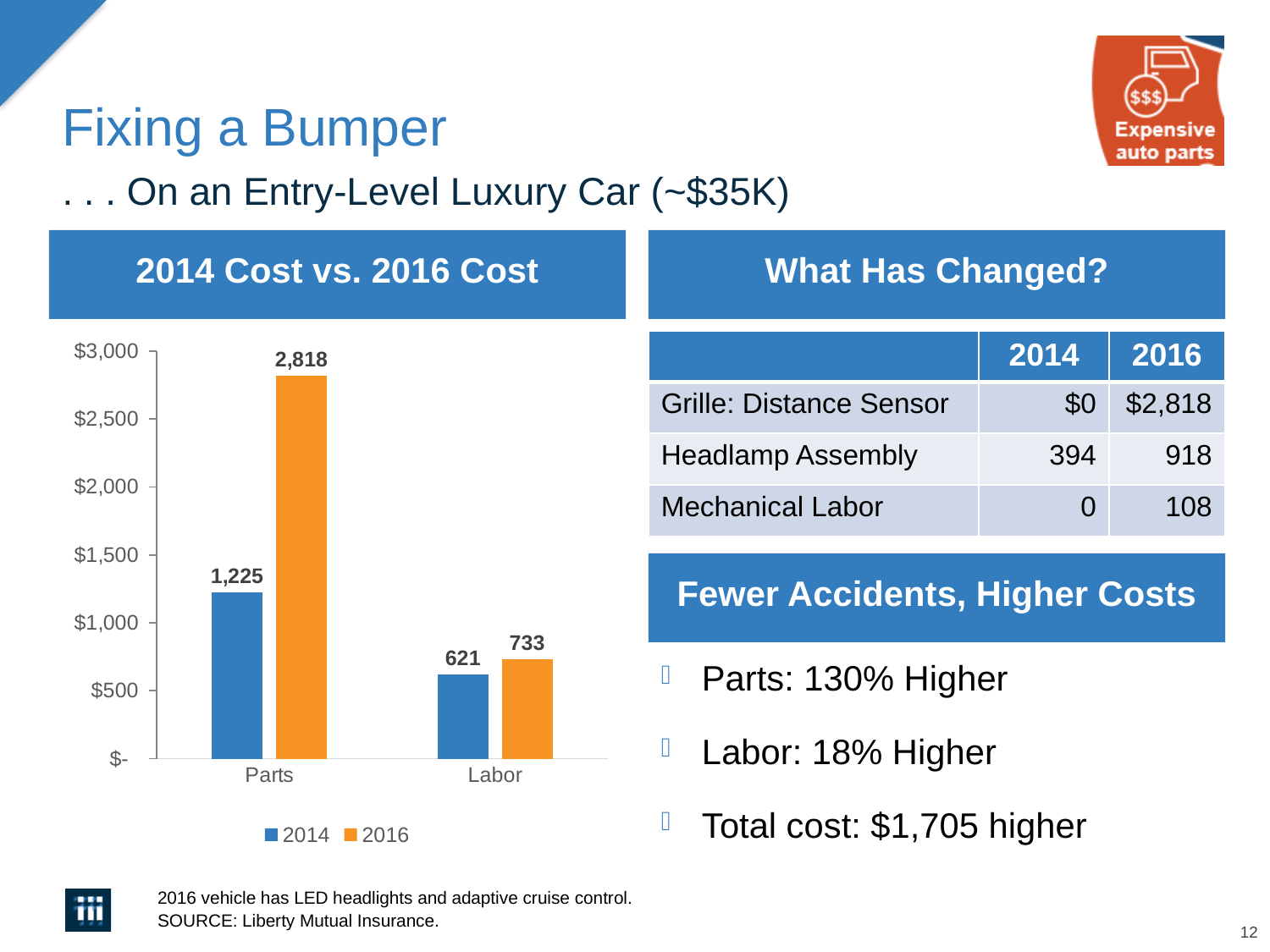
What kind of chart is shown? bar chart How many series does the legend list? 2 Which category has the highest 2016 value? Parts Which category has the lowest 2014 value? Labor What is the difference between the 2016 and 2014 values for Parts? 1,593 What is the 2016 value for Parts? 2,818 How many categories are shown on the x axis? 2 What is the 2014 value for Parts? 1,225 What is the 2016 value for Labor? 733 What is the 2014 value for Labor? 621 Which is larger, the 2014 value for Parts or the 2016 value for Labor? 2014 value for Parts Is the 2016 value for Parts greater or less than $2,500? greater